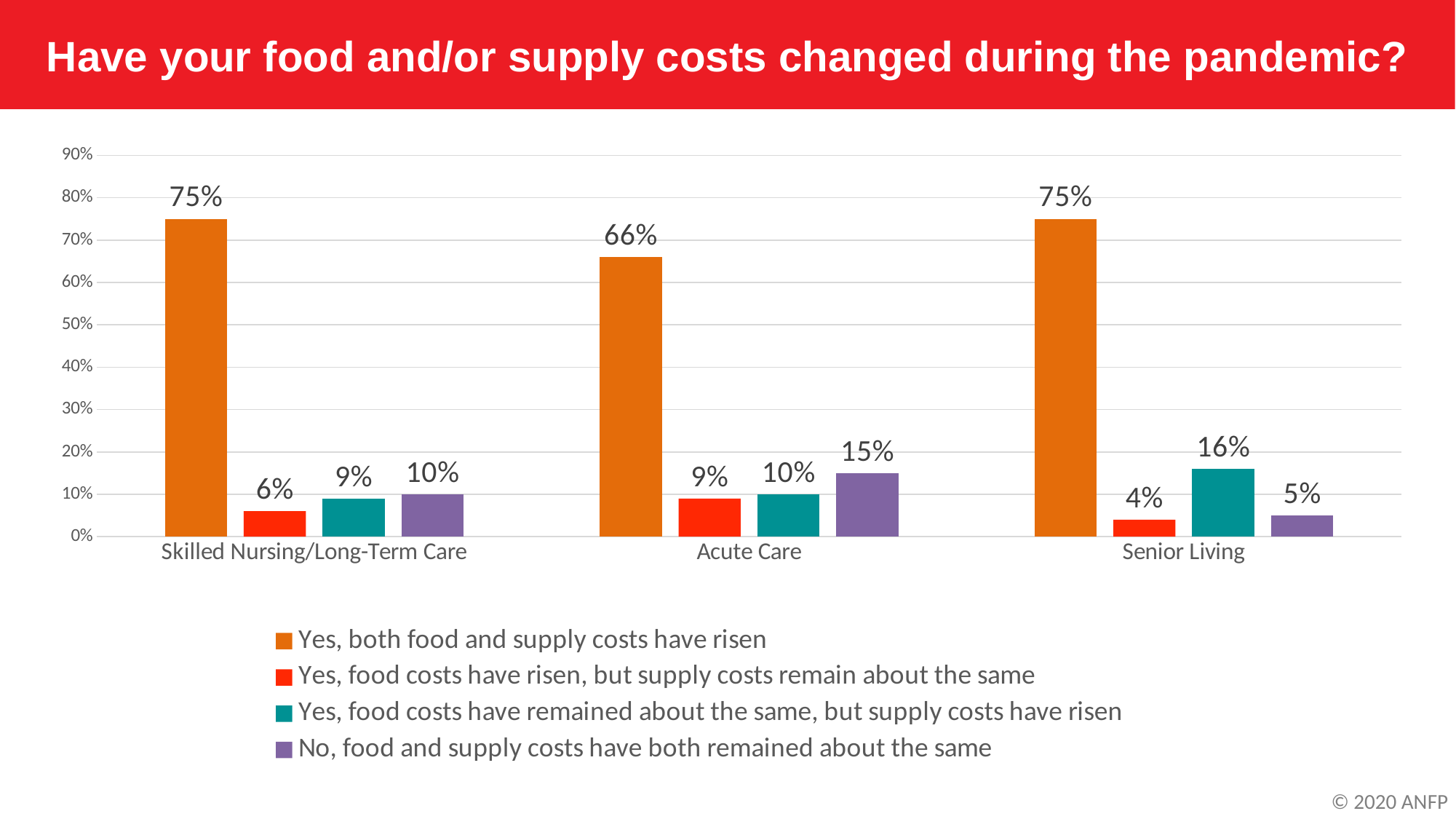
What colour are the bars for 'Yes, both food and supply costs have risen'? Orange Which is larger: the 'No, food and supply costs have both remained about the same' value for Acute Care or for Senior Living? Acute Care What kind of chart is shown on the slide? Bar chart What percentage of Acute Care respondents said both food and supply costs have risen? 66% How many categories are shown on the x axis? 3 What is the difference between the 'Yes, both food and supply costs have risen' values for Skilled Nursing/Long-Term Care and Acute Care? 9% What percentage of Skilled Nursing/Long-Term Care respondents said food costs have risen but supply costs remain about the same? 6% What is the title of the chart? Have your food and/or supply costs changed during the pandemic? What is the value for 'No, food and supply costs have both remained about the same' in the Senior Living category? 5% How many series does the legend list? 4 Which category has the highest value for 'Yes, food costs have remained about the same, but supply costs have risen'? Senior Living Which category has the lowest value for 'Yes, both food and supply costs have risen'? Acute Care